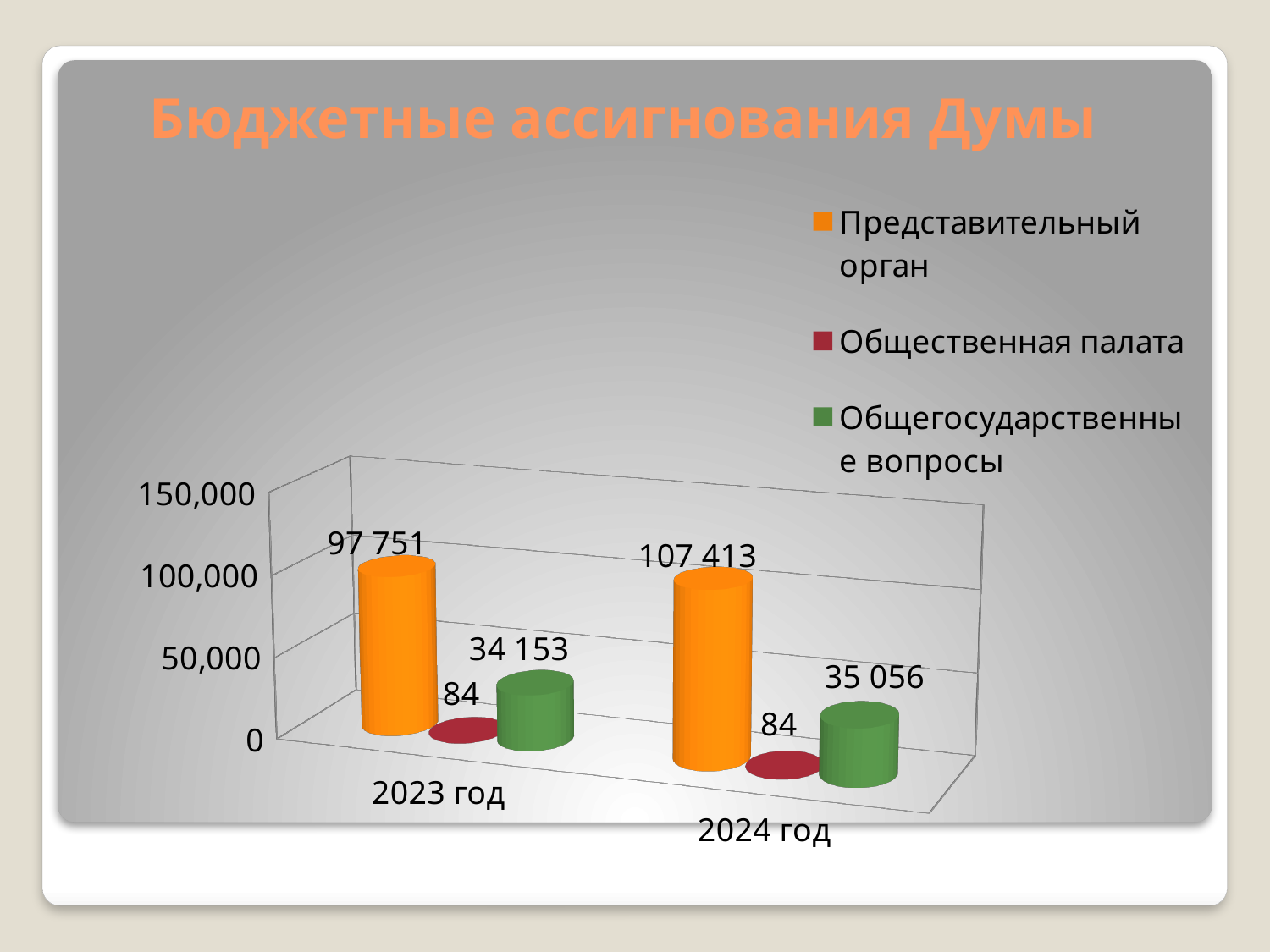
How many categories are shown on the x axis? 2 What is the value for Общественная палата in 2023 год? 84 Which is larger: Общегосударственные вопросы in 2023 год or in 2024 год? 2024 год What is the value for Представительный орган in 2023 год? 97 751 What is the difference between the Представительный орган values for 2024 год and 2023 год? 9 662 How many series does the legend list? 3 What is the value for Представительный орган in 2024 год? 107 413 Which series has the highest value in 2024 год? Представительный орган Which series has the lowest value in 2023 год? Общественная палата What kind of chart is shown on the slide? bar chart Is the value for Представительный орган in 2024 год greater or less than 100,000? greater What is the value for Общегосударственные вопросы in 2024 год? 35 056